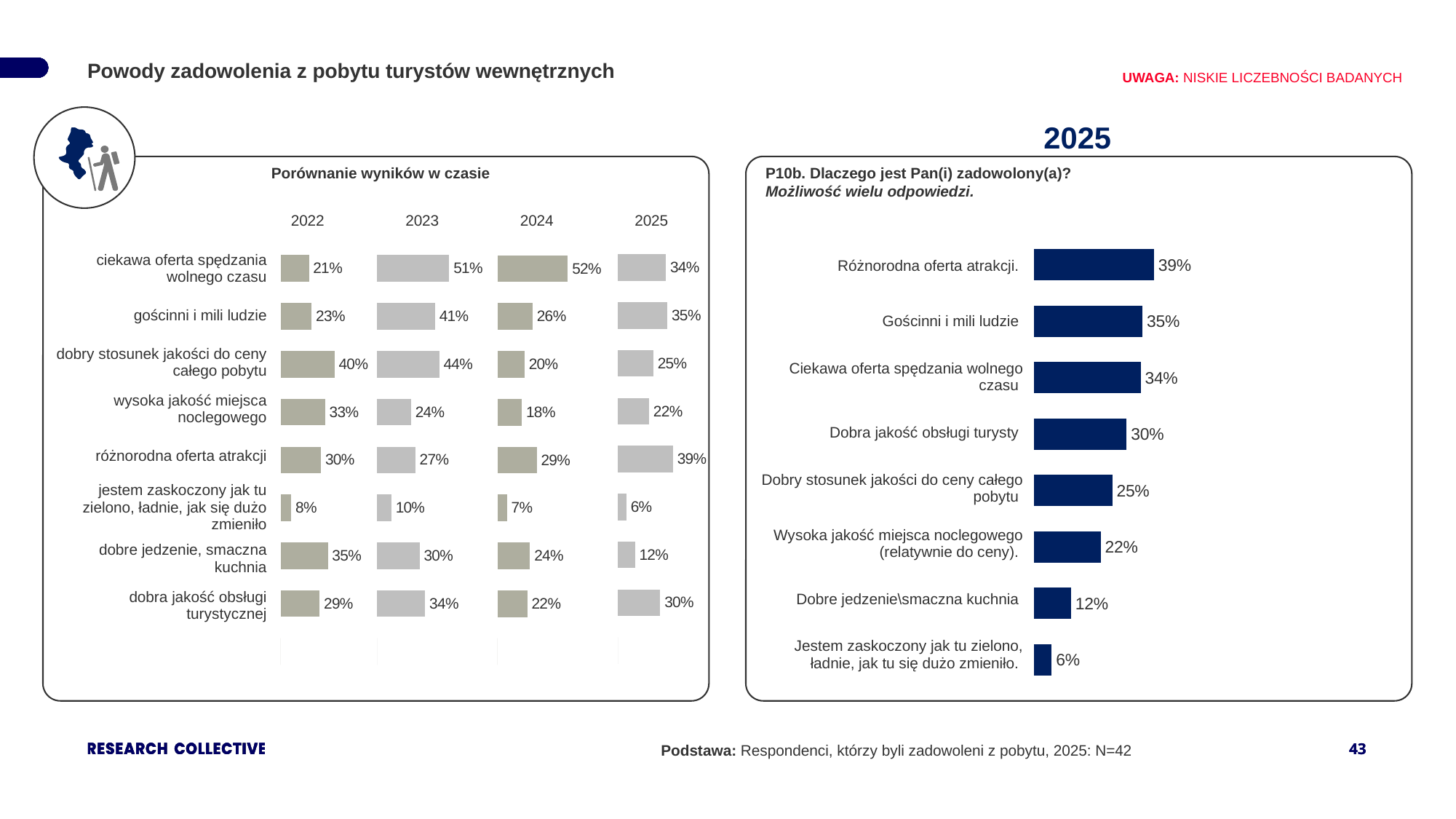
In the 2025 chart on the right, how many categories are shown? 8 In the 2025 chart on the right, what is the difference between "Gościnni i mili ludzie" and "Dobre jedzenie\smaczna kuchnia"? 23 percentage points In the 2025 chart on the right, what is the value for "Różnorodna oferta atrakcji."? 39% In the "Porównanie wyników w czasie" chart, what is the difference between the 2024 and 2025 values for "ciekawa oferta spędzania wolnego czasu"? 18 percentage points In the "Porównanie wyników w czasie" chart, do the values for "dobre jedzenie, smaczna kuchnia" rise or fall from 2022 to 2025? Fall In the "Porównanie wyników w czasie" chart, is the value for "gościnni i mili ludzie" larger in 2022 or in 2025? 2025 In the 2025 chart on the right, which category has the highest value? Różnorodna oferta atrakcji. In the "Porównanie wyników w czasie" chart, how many years are compared? 4 In the "Porównanie wyników w czasie" chart, what is the value for "dobry stosunek jakości do ceny całego pobytu" in 2023? 44% In the 2025 chart on the right, which category has the lowest value? Jestem zaskoczony jak tu zielono, ładnie, jak tu się dużo zmieniło. What kind of chart is the 2025 chart on the right? Bar chart In the "Porównanie wyników w czasie" chart, in which year was the value for "ciekawa oferta spędzania wolnego czasu" highest? 2024